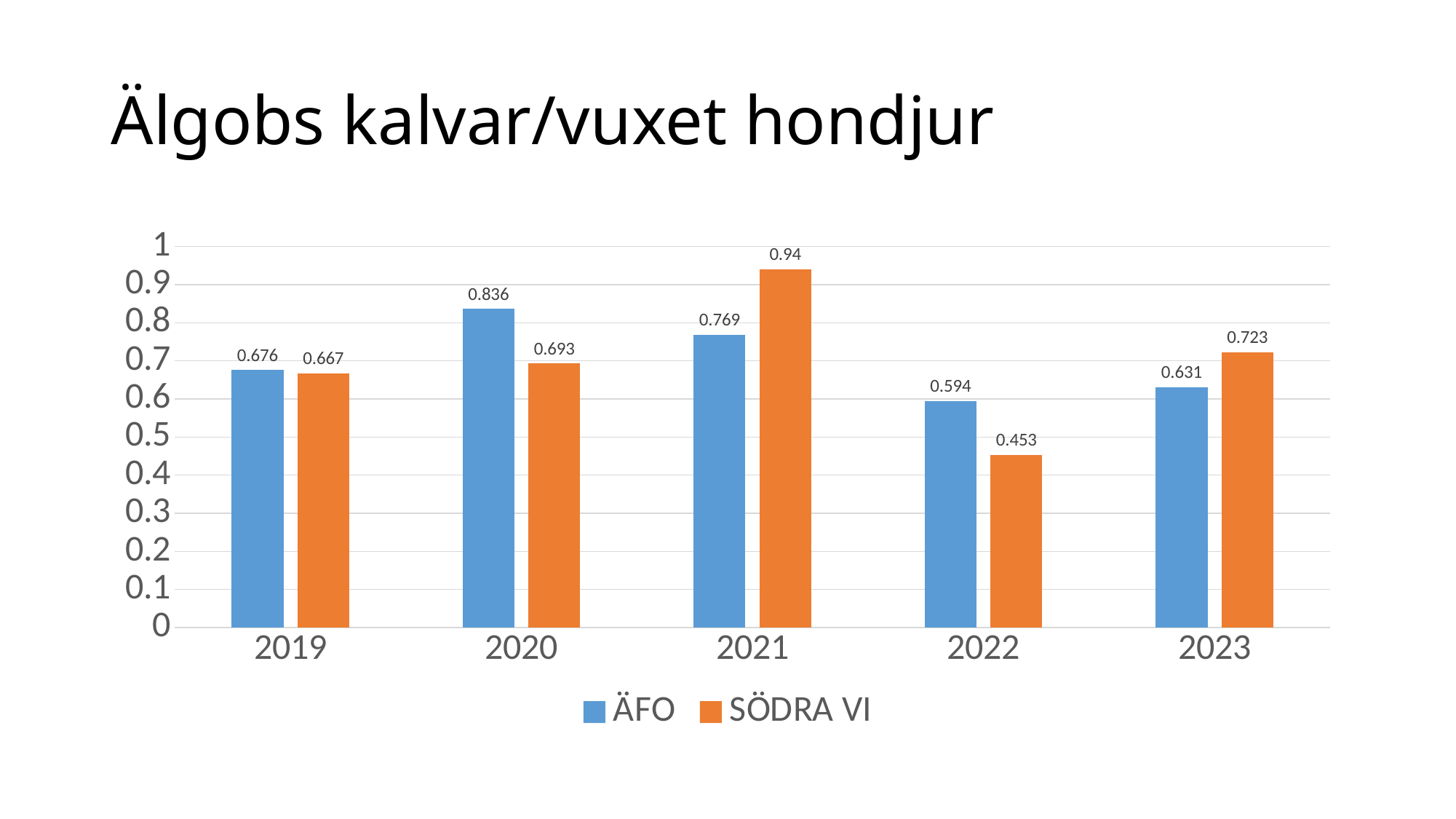
What is the value for SÖDRA VI in 2023? 0.723 Is the value for ÄFO in 2021 greater or less than 0.7? greater Which series has the larger value in 2022, ÄFO or SÖDRA VI? ÄFO In which year is the ÄFO value lowest? 2022 What kind of chart is shown on the slide? Bar chart What is the difference between the SÖDRA VI value and the ÄFO value in 2021? 0.171 What is the title of the slide? Älgobs kalvar/vuxet hondjur In which year is the SÖDRA VI value highest? 2021 What is the value for SÖDRA VI in 2022? 0.453 How many series does the legend list? 2 How many years are shown on the x axis? 5 What is the value for ÄFO in 2020? 0.836